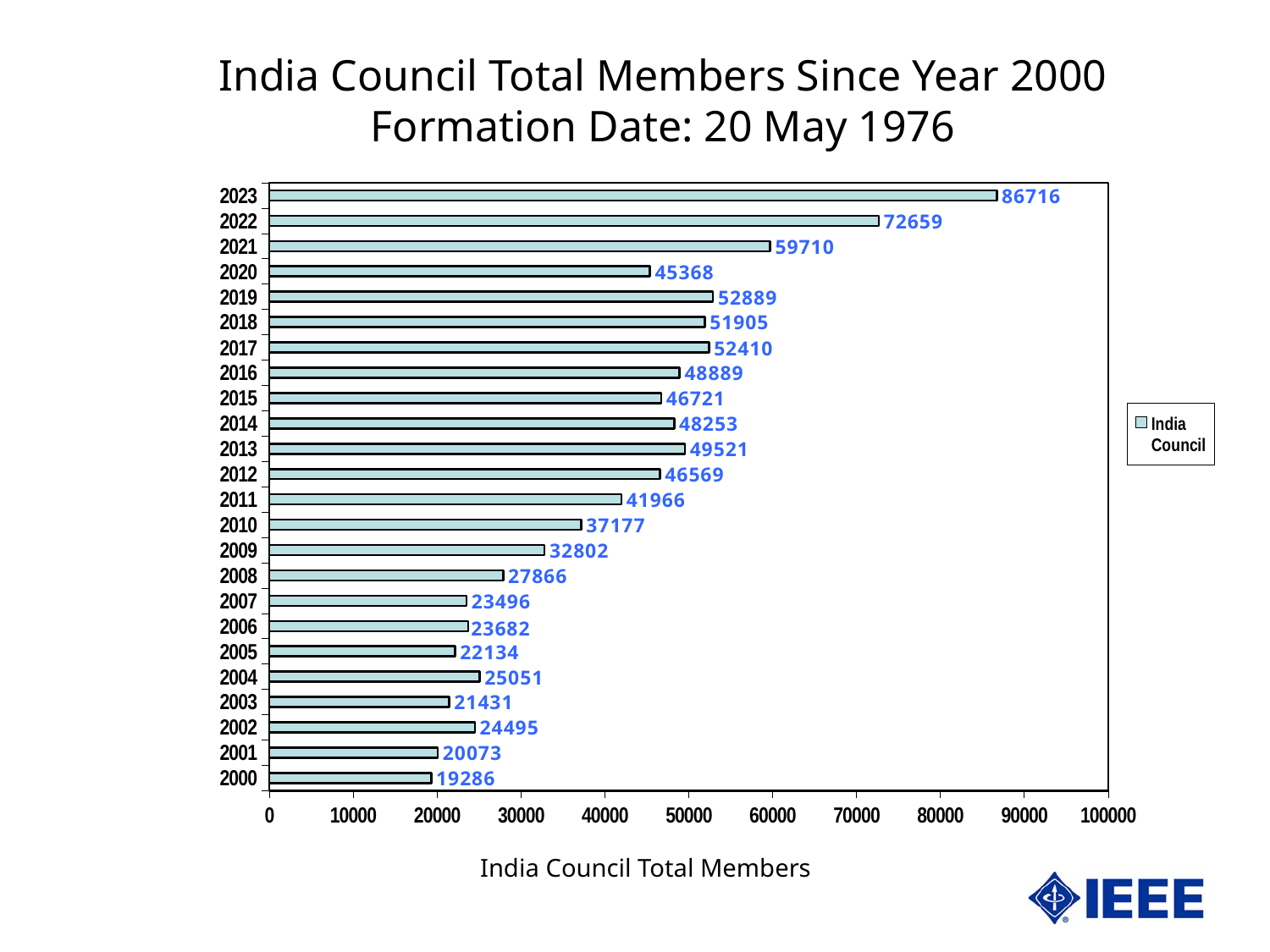
Which year had more members, 2019 or 2020? 2019 What kind of chart is shown on the slide? Bar chart What is the India Council total membership for 2023? 86716 Which year has the highest India Council total membership? 2023 What is the India Council total membership for 2000? 19286 What is the difference in total members between 2023 and 2022? 14057 Is the value for 2022 greater or less than 70000? greater What is the India Council total membership for 2010? 37177 How many years are shown on the chart? 24 Which year has the lowest India Council total membership? 2000 How many series does the legend list? 1 What is the difference in total members between 2021 and 2020? 14342